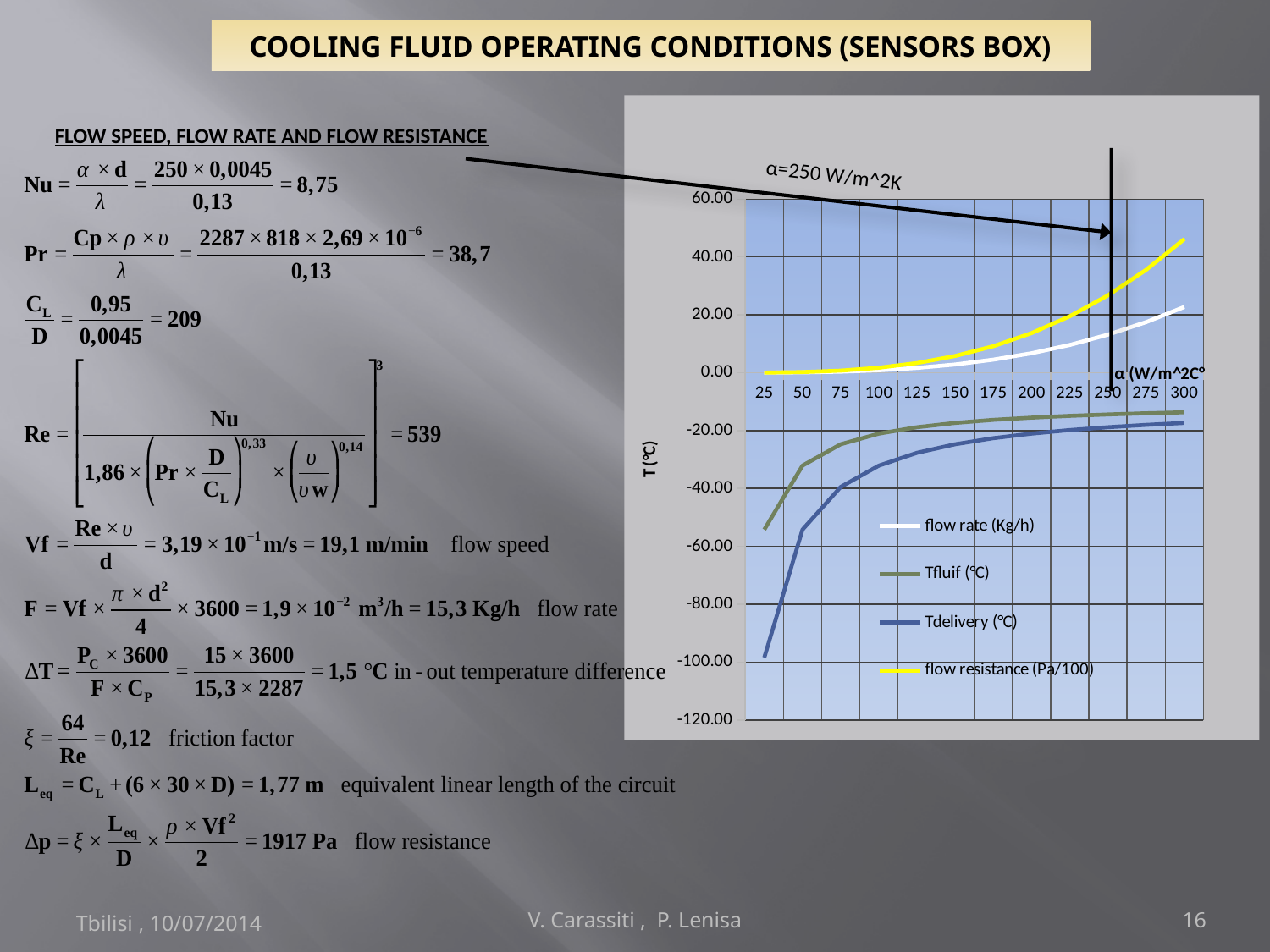
How many series does the chart legend list? 4 Is the value of Tdelivery (°C) at α = 25 greater or less than -80.00? less What is the label on the vertical axis of the chart? T (°C) At α = 25, which is higher: Tfluif (°C) or Tdelivery (°C)? Tfluif (°C) What kind of chart is shown on the slide? line chart At α = 300, which is larger: flow resistance (Pa/100) or flow rate (Kg/h)? flow resistance (Pa/100) Is the value of Tfluif (°C) at α = 25 greater or less than -40.00? less Does the Tdelivery (°C) series rise or fall as α increases along the x axis? rises Which series reaches the highest value on the chart at α = 300? flow resistance (Pa/100) Does the flow resistance (Pa/100) series rise or fall as α increases along the x axis? rises Is the value of flow resistance (Pa/100) at α = 300 greater or less than 40.00? greater How many α values are marked along the x axis of the chart? 12